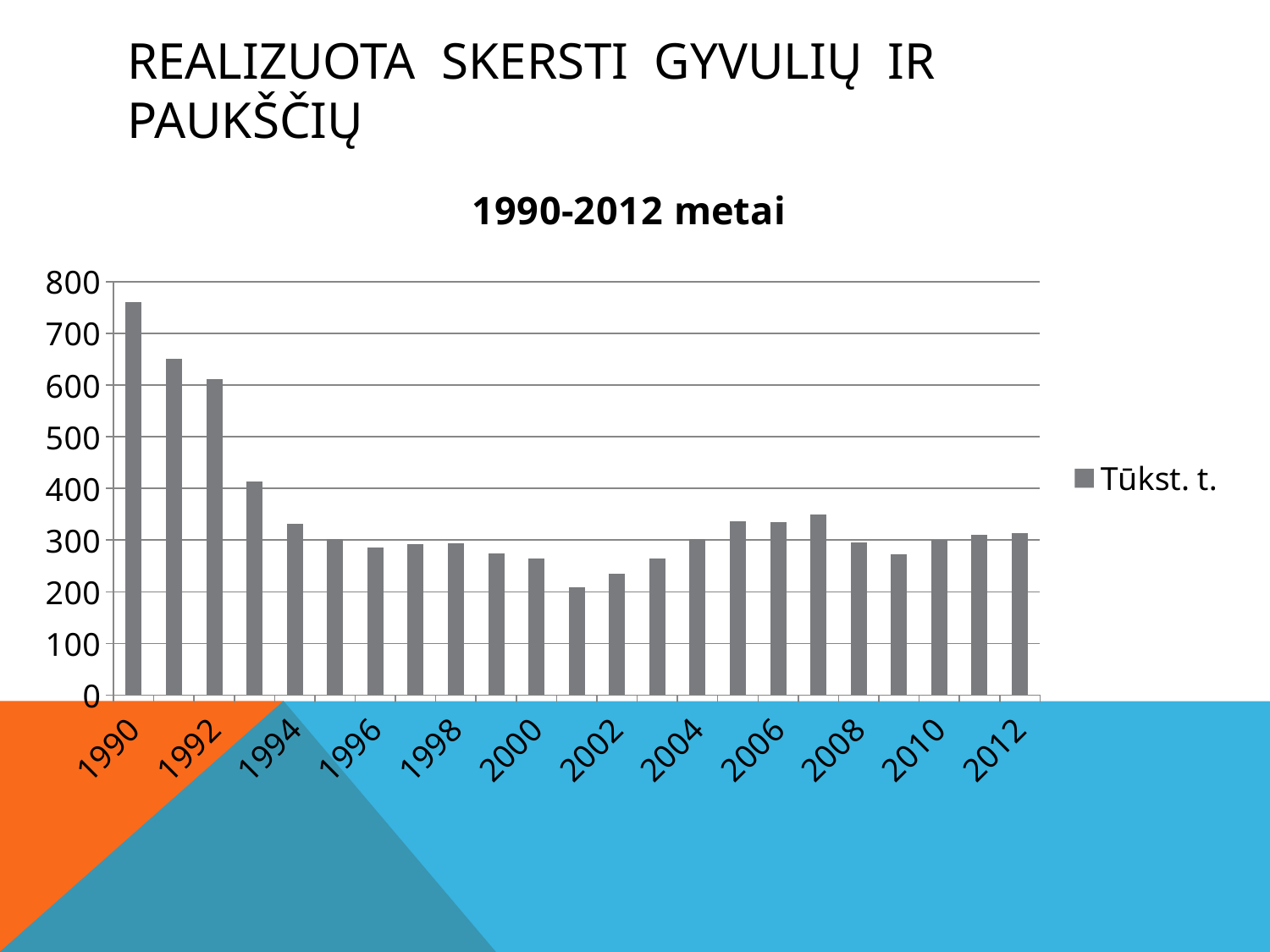
How many bars are plotted in the chart? 23 What is the title of the chart? 1990-2012 metai Which year has the highest value? 1990 Is the value for 1992 greater or less than 500? greater Overall, do the values rise or fall from 1990 to 2012? fall Is the value for 1990 greater or less than 700? greater What is the legend entry for the series? Tūkst. t. Is the value for 2002 greater or less than 300? less What kind of chart is shown on the slide? bar chart How many series does the legend list? 1 Which is larger, the value for 1990 or the value for 2012? 1990